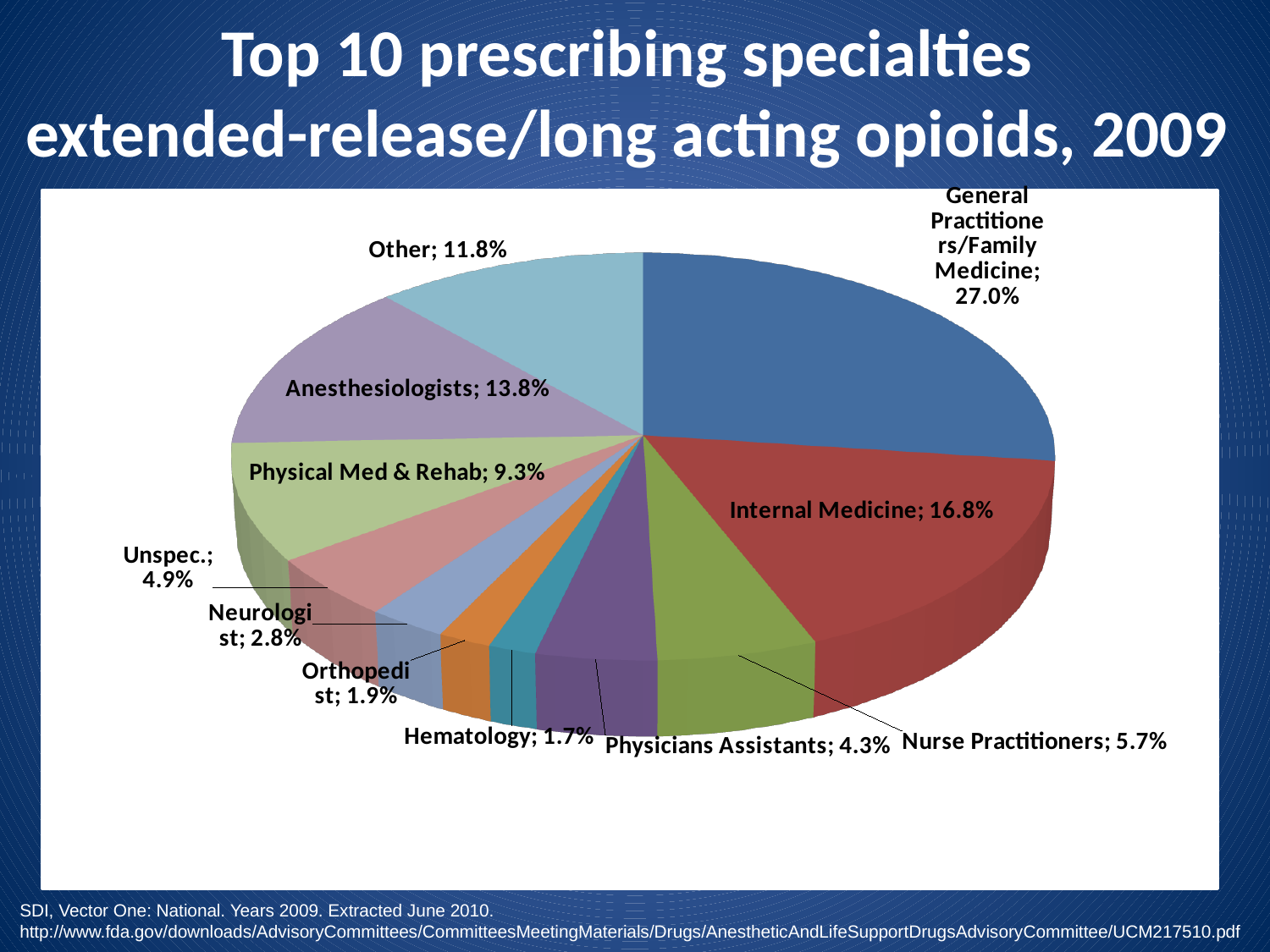
What is the title of the slide containing the chart? Top 10 prescribing specialties extended-release/long acting opioids, 2009 What is the value for Physical Med & Rehab? 9.3% What share of the pie is General Practitioners/Family Medicine? 27.0% Which specialty has the largest slice of the pie? General Practitioners/Family Medicine Which is larger, the share for Other or the share for Physical Med & Rehab? Other How many slices does the pie chart have? 11 What percentage is shown for Anesthesiologists? 13.8% What is the combined share of Neurologist and Orthopedist? 4.7% Which is larger, Physicians Assistants or Unspec.? Unspec. What is the difference in percentage points between Internal Medicine and Nurse Practitioners? 11.1 What kind of chart is shown on the slide? Pie chart Which category has the smallest slice of the pie? Hematology